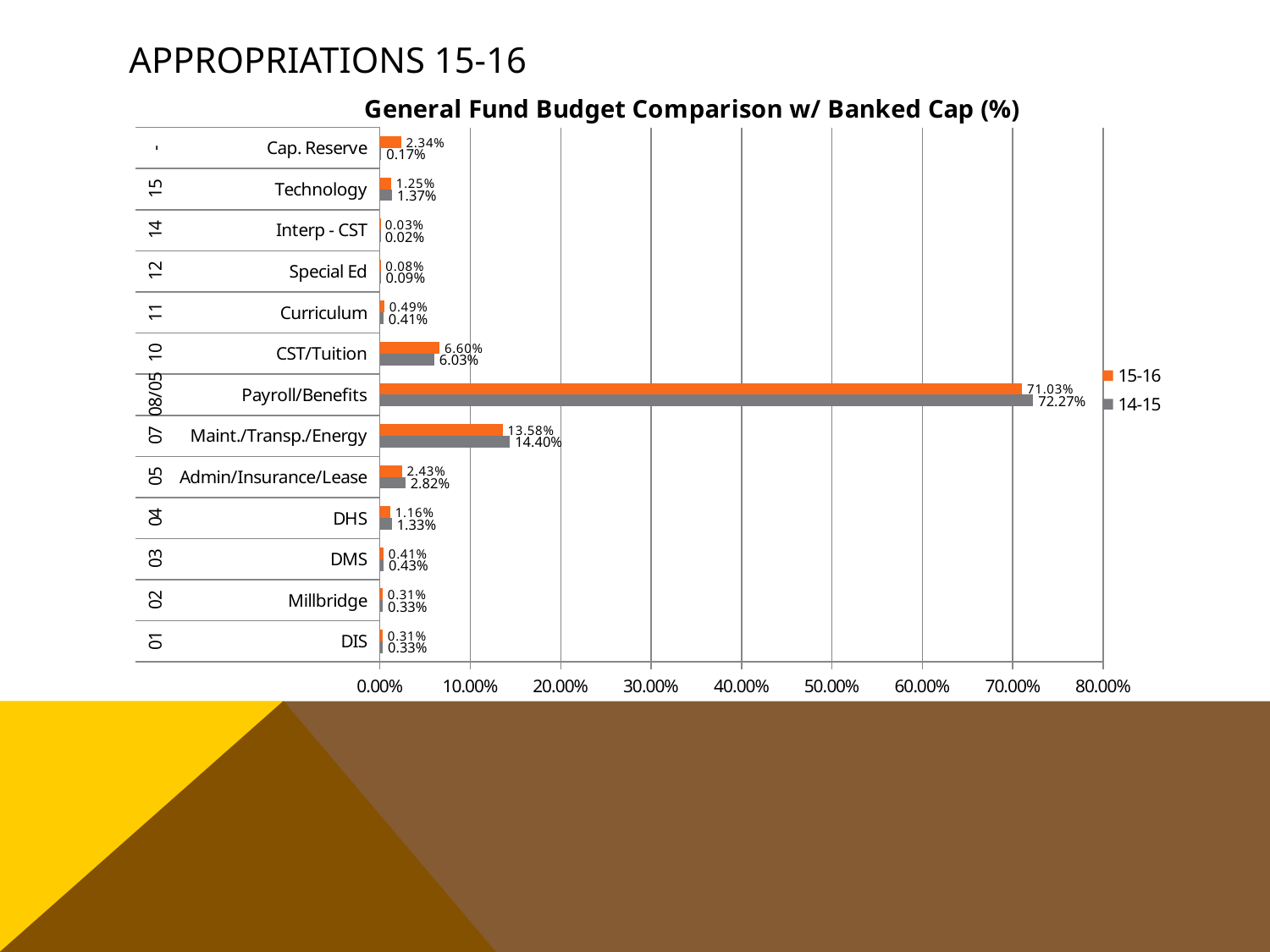
Is the 15-16 value for Payroll/Benefits greater or less than 70.00%? greater How many series does the legend list? 2 Which category has the lowest 14-15 value? Interp - CST For Admin/Insurance/Lease, which series has the larger value, 15-16 or 14-15? 14-15 How many categories are shown on the chart? 13 Which category has the highest 15-16 value? Payroll/Benefits What type of chart is shown on the slide? Bar chart What is the 14-15 value for Maint./Transp./Energy? 14.40% What is the 14-15 value for CST/Tuition? 6.03% What is the 15-16 value for Payroll/Benefits? 71.03% What is the 15-16 value for Cap. Reserve? 2.34% What is the difference between the 14-15 and 15-16 values for Payroll/Benefits? 1.24%